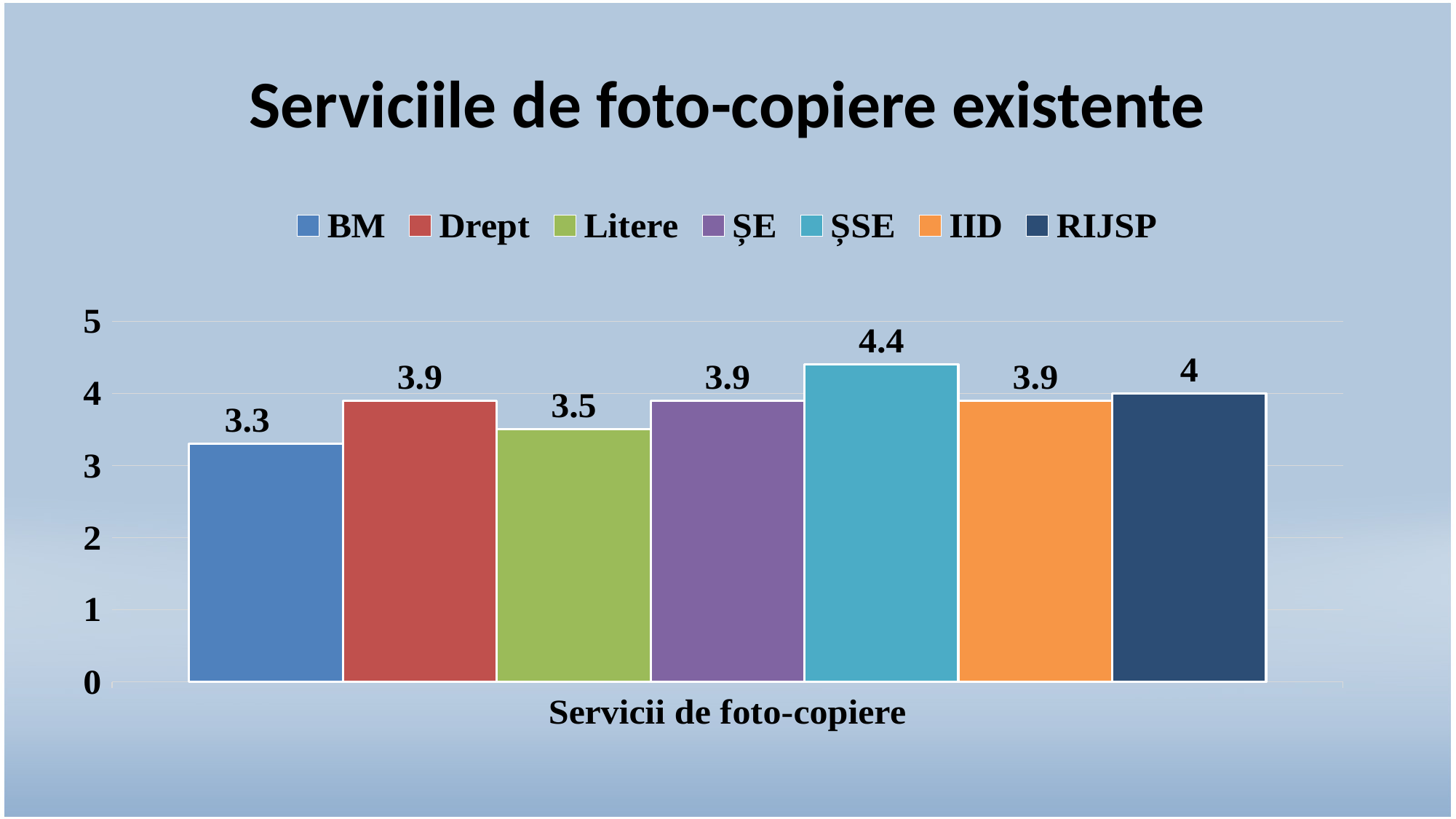
Which series has the lowest value? BM How many series does the legend list? 7 What is the value for Litere? 3.5 What kind of chart is shown on the slide? bar chart What is the title of the chart? Serviciile de foto-copiere existente Which series has the highest value? ȘSE Is the value for Drept greater or less than 3? greater Which is larger, the value for RIJSP or the value for Litere? RIJSP What is the value for ȘSE? 4.4 What is the difference between the values for ȘSE and BM? 1.1 What is the value for BM? 3.3 What is the value for RIJSP? 4